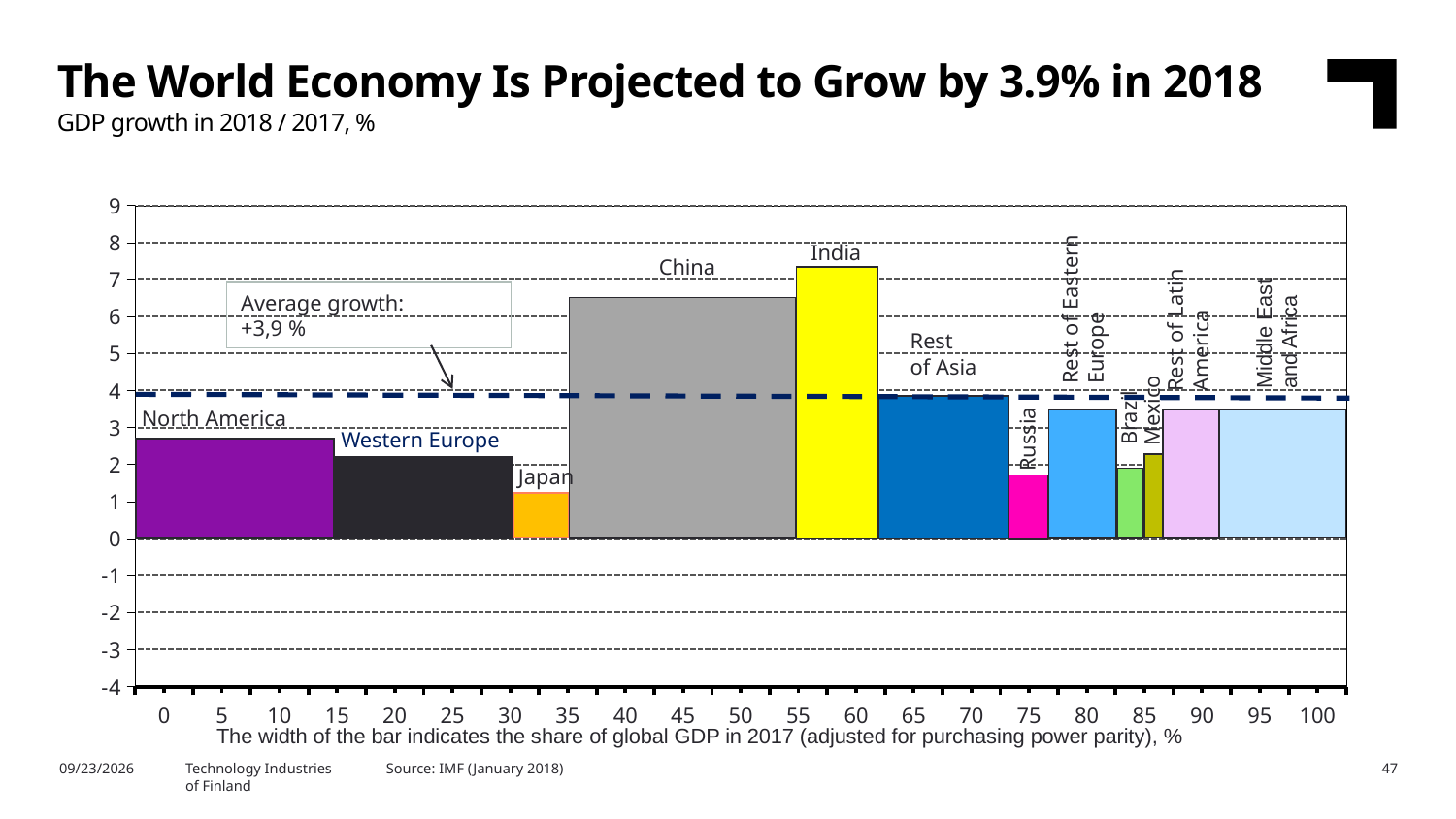
Which has the higher projected GDP growth, China or India? India Is the value for North America greater or less than 3? less Which region has the highest projected GDP growth in the chart? India What average growth value is printed on the chart? +3,9 % Which region has the lowest projected GDP growth in the chart? Japan Is the value for Japan greater or less than 2? less Is the value for China greater or less than 6? greater Which has the higher projected GDP growth, Western Europe or Japan? Western Europe According to the note below the x axis, what does the width of each bar indicate? The share of global GDP in 2017 (adjusted for purchasing power parity), % How many regions are shown as bars in the chart? 12 What kind of chart is shown on the slide? bar chart